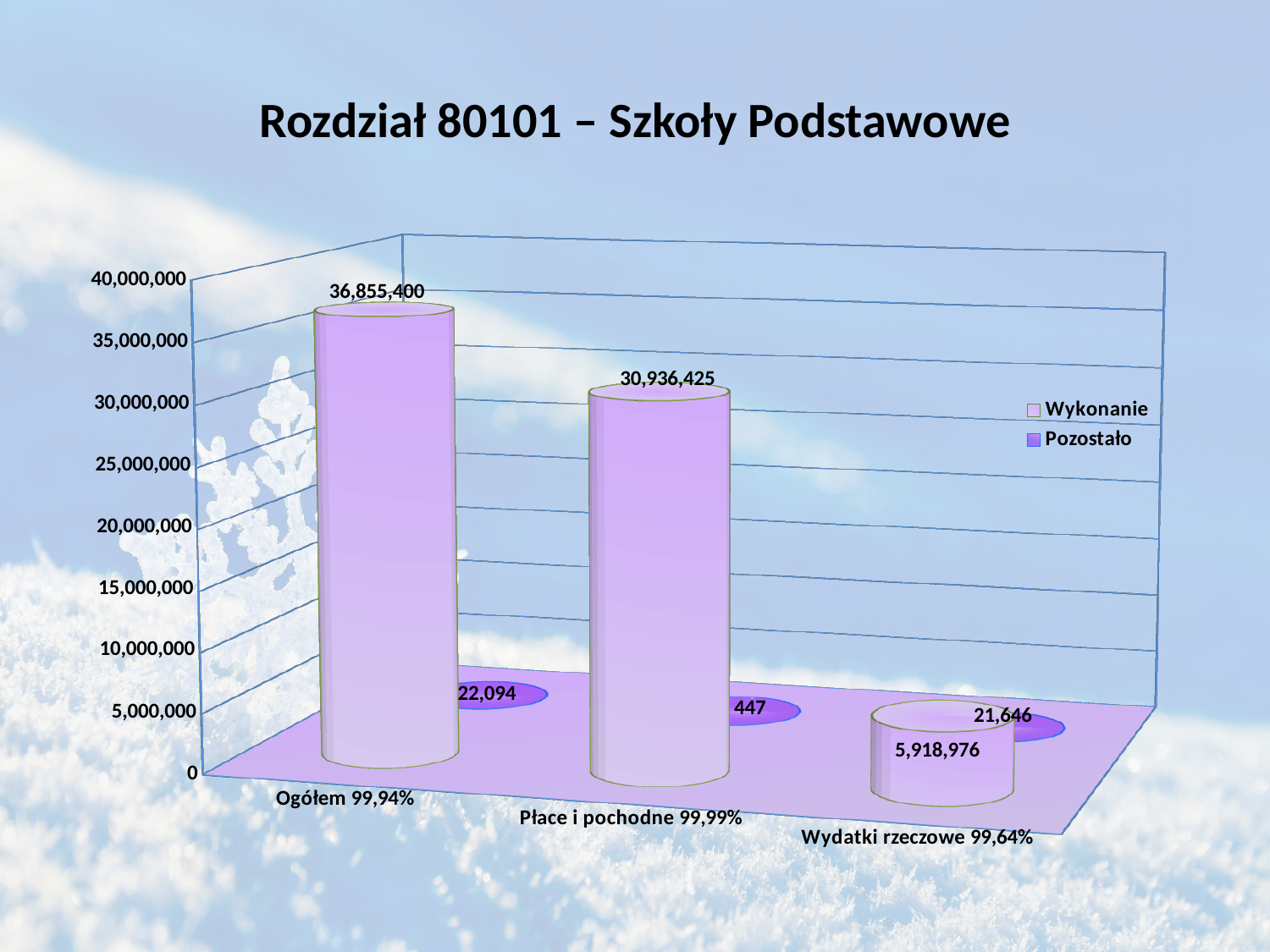
Which category has the lowest Pozostało value? Płace i pochodne 99,99% What is the Pozostało value for Płace i pochodne 99,99%? 447 What is the difference between the Wykonanie values for Ogółem 99,94% and Płace i pochodne 99,99%? 5,918,975 Is the Wykonanie value for Wydatki rzeczowe 99,64% greater or less than 10,000,000? less What is the Wykonanie value for Ogółem 99,94%? 36,855,400 How many series does the legend list? 2 What is the Wykonanie value for Wydatki rzeczowe 99,64%? 5,918,976 What is the Pozostało value for Wydatki rzeczowe 99,64%? 21,646 Which category has the highest Wykonanie value? Ogółem 99,94% What is the title of the chart? Rozdział 80101 – Szkoły Podstawowe What is the Wykonanie value for Płace i pochodne 99,99%? 30,936,425 What is the Pozostało value for Ogółem 99,94%? 22,094